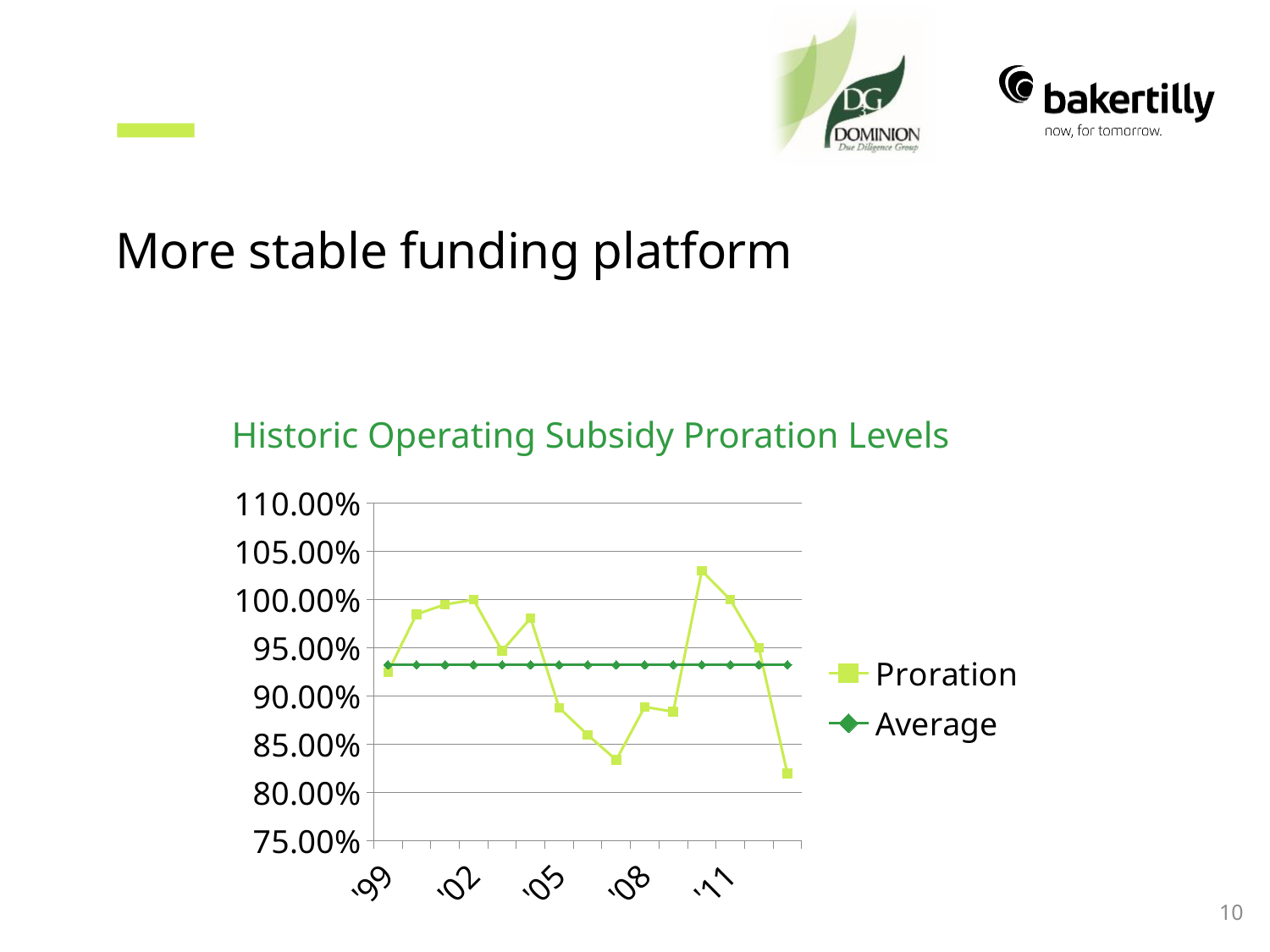
Is the Proration value for '99 greater or less than 95.00%? less Is the Average line greater or less than 95.00%? less Which year has the highest Proration value? '10 What are the two series named in the legend? Proration and Average What type of chart is shown on the slide? line chart Is the Proration value for '05 greater or less than 95.00%? less What is the title of the chart? Historic Operating Subsidy Proration Levels How many series does the legend list? 2